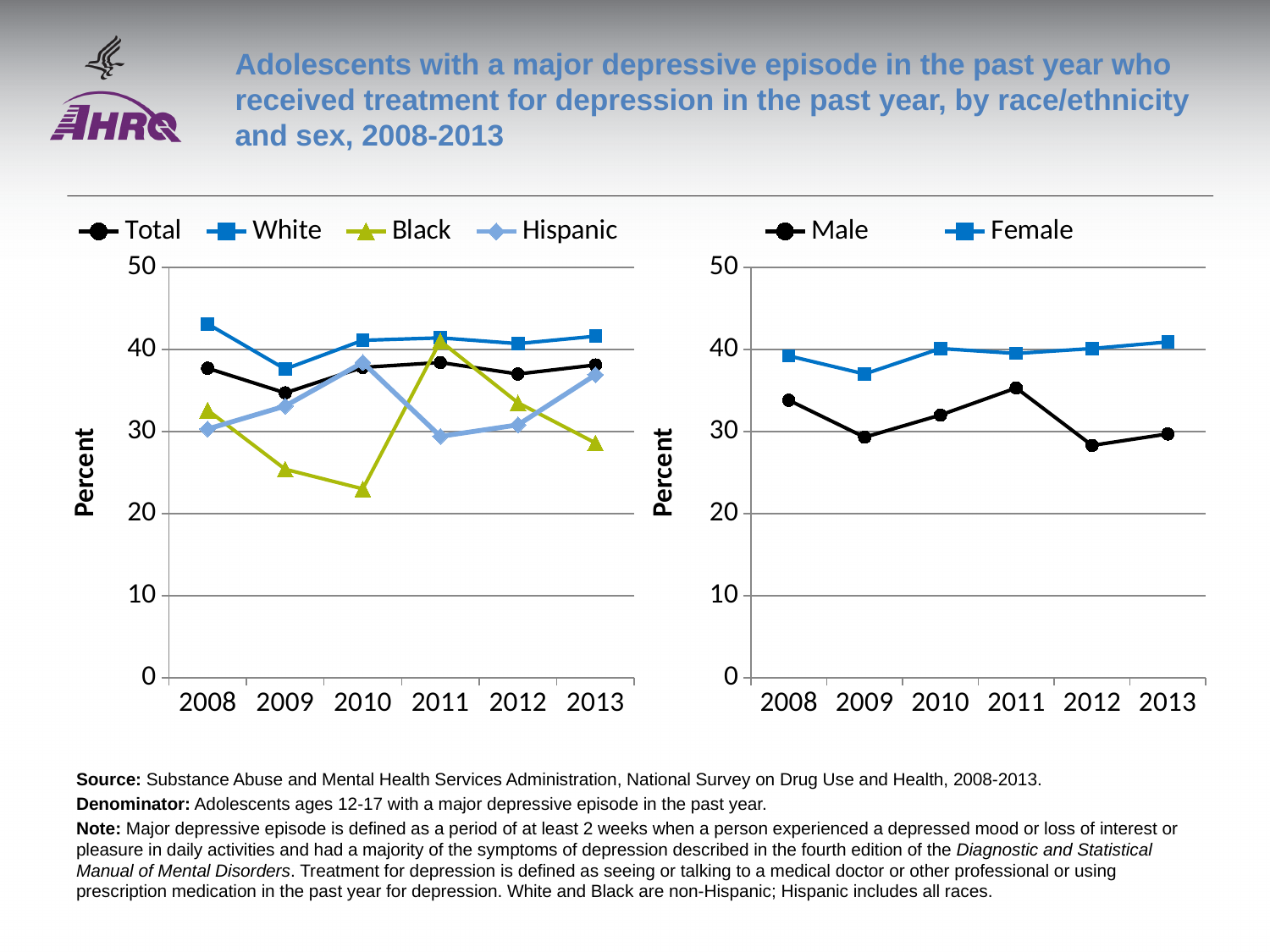
In the right chart (by sex), which is larger in 2012, Male or Female? Female In the left chart (by race/ethnicity), which series has the highest value in 2013? White What kind of chart is the left chart showing treatment by race/ethnicity? line chart How many series does the legend of the left chart (by race/ethnicity) list? 4 In the left chart (by race/ethnicity), in which year is the Black series at its highest? 2011 In the left chart (by race/ethnicity), is the value for White in 2008 greater or less than 40? greater What is the label on the y axis of the right chart (by sex)? Percent In the left chart (by race/ethnicity), is the value for Black in 2010 greater or less than 30? less In the left chart (by race/ethnicity), which series has the lowest value in 2010? Black How many series does the legend of the right chart (by sex) list? 2 How many years are shown on the x axis of the right chart (by sex)? 6 In the right chart (by sex), is the value for Male in 2012 greater or less than 30? less